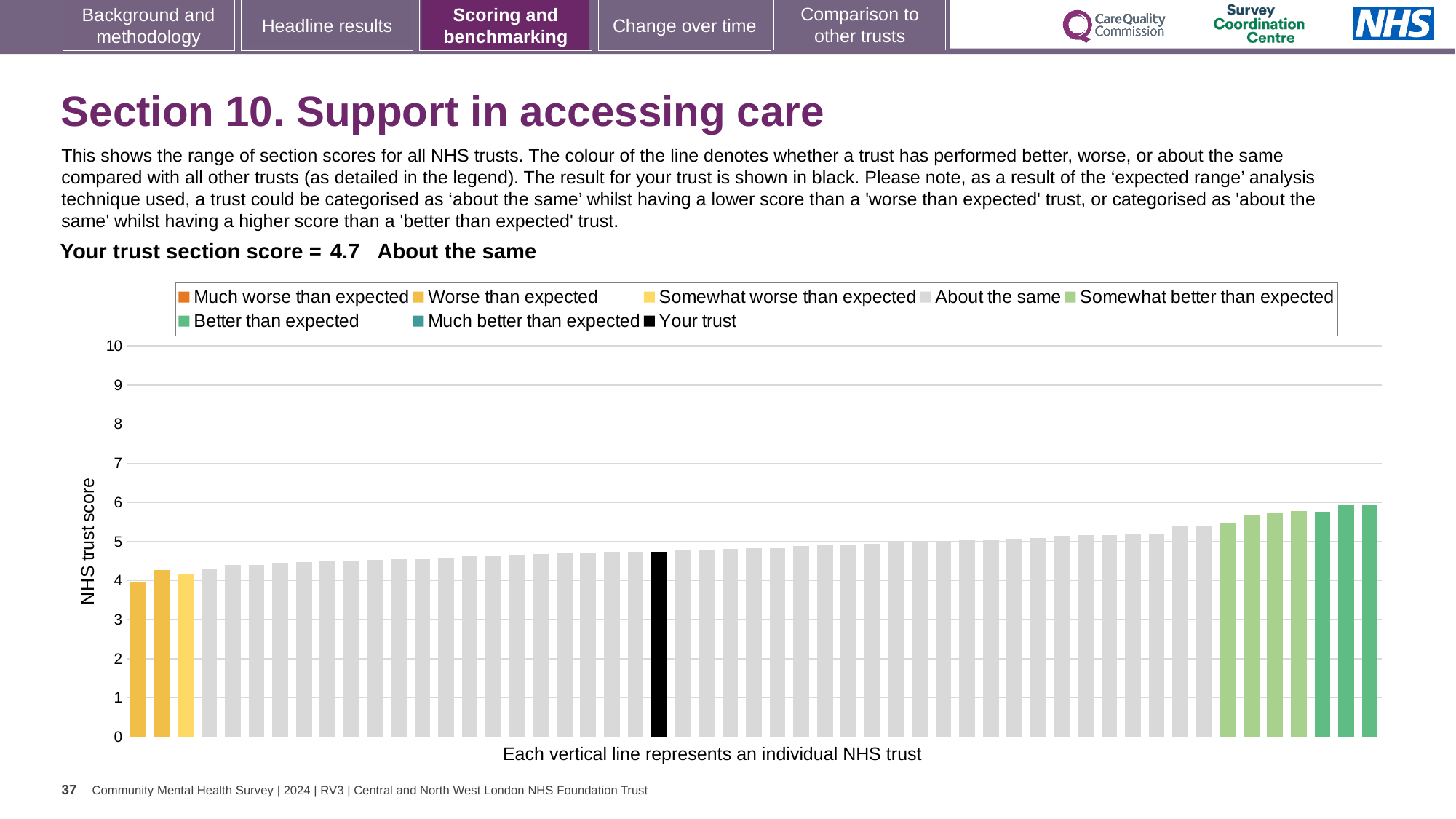
What is the section score for your trust shown on the slide? 4.7 How many bars are coloured as 'Somewhat better than expected'? 4 What is the label on the vertical axis of the chart? NHS trust score How many entries does the chart legend list? 8 Do the bar values rise or fall from left to right along the x axis? rise Is the value of the shortest bar greater or less than 3? greater How many bars are coloured as 'Worse than expected'? 2 Is the value for your trust greater or less than 5? less Which legend category does the tallest bar belong to? Better than expected What kind of chart is shown on the slide? bar chart Is the value for your trust greater or less than 4? greater